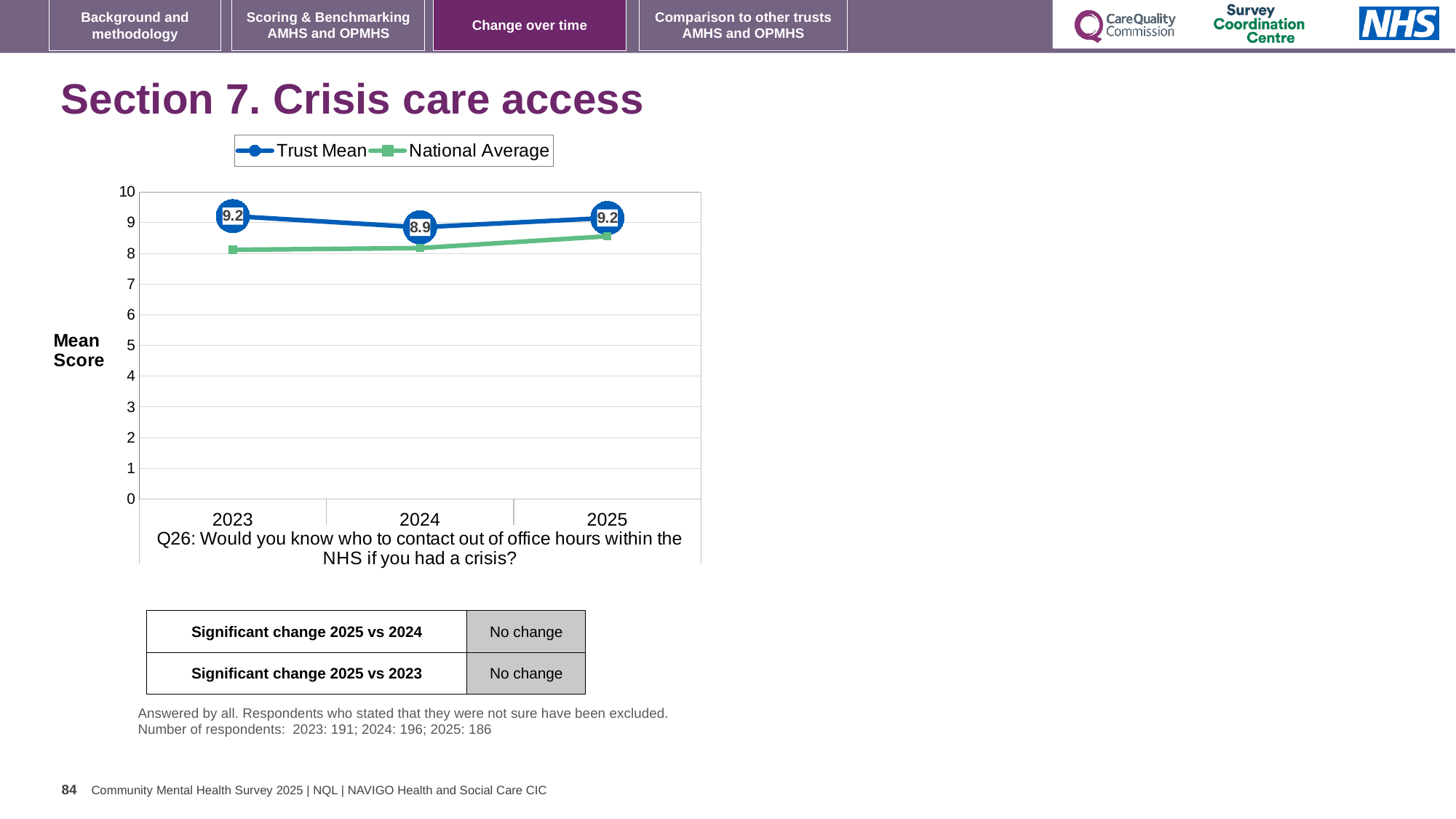
Is the National Average value for 2025 greater or less than 8? greater How many years are plotted on the x axis? 3 What is the Trust Mean value for 2024? 8.9 In which year is the Trust Mean lowest? 2024 What is the Trust Mean value for 2025? 9.2 What kind of chart is shown on the slide? Line chart In 2024, which is larger: the Trust Mean or the National Average? Trust Mean Is the National Average value for 2023 greater or less than 9? less What is the difference between the Trust Mean in 2023 and in 2024? 0.3 Does the National Average rise or fall from 2023 to 2025? Rise What is the Trust Mean value for 2023? 9.2 How many series does the legend list? 2